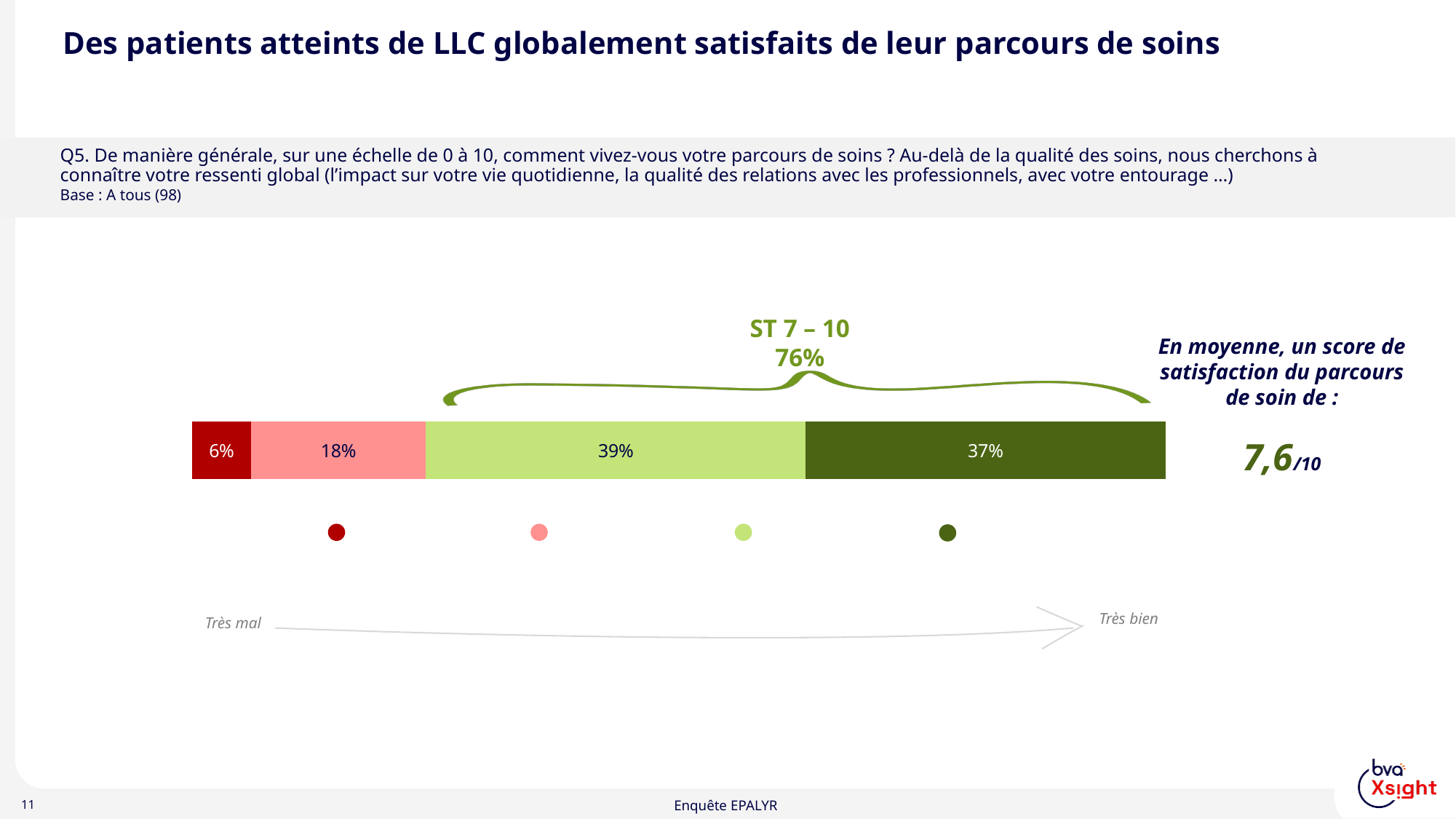
What is the value of the pink segment of the bar? 18% What kind of chart is shown on the slide? bar chart What is the value of the leftmost (dark red) segment of the bar? 6% What is the value of the light green segment of the bar? 39% How many segments make up the stacked bar? 4 What average satisfaction score is shown on the slide? 7,6/10 What is the value of the rightmost (dark green) segment of the bar? 37% What percentage is shown for ST 7 – 10 above the bar? 76% Which is larger, the light green segment or the dark green segment? the light green segment Which segment of the bar has the lowest value? the dark red segment (6%) Which segment of the bar has the highest value? the light green segment (39%) What is the difference between the pink segment and the dark red segment? 12 percentage points